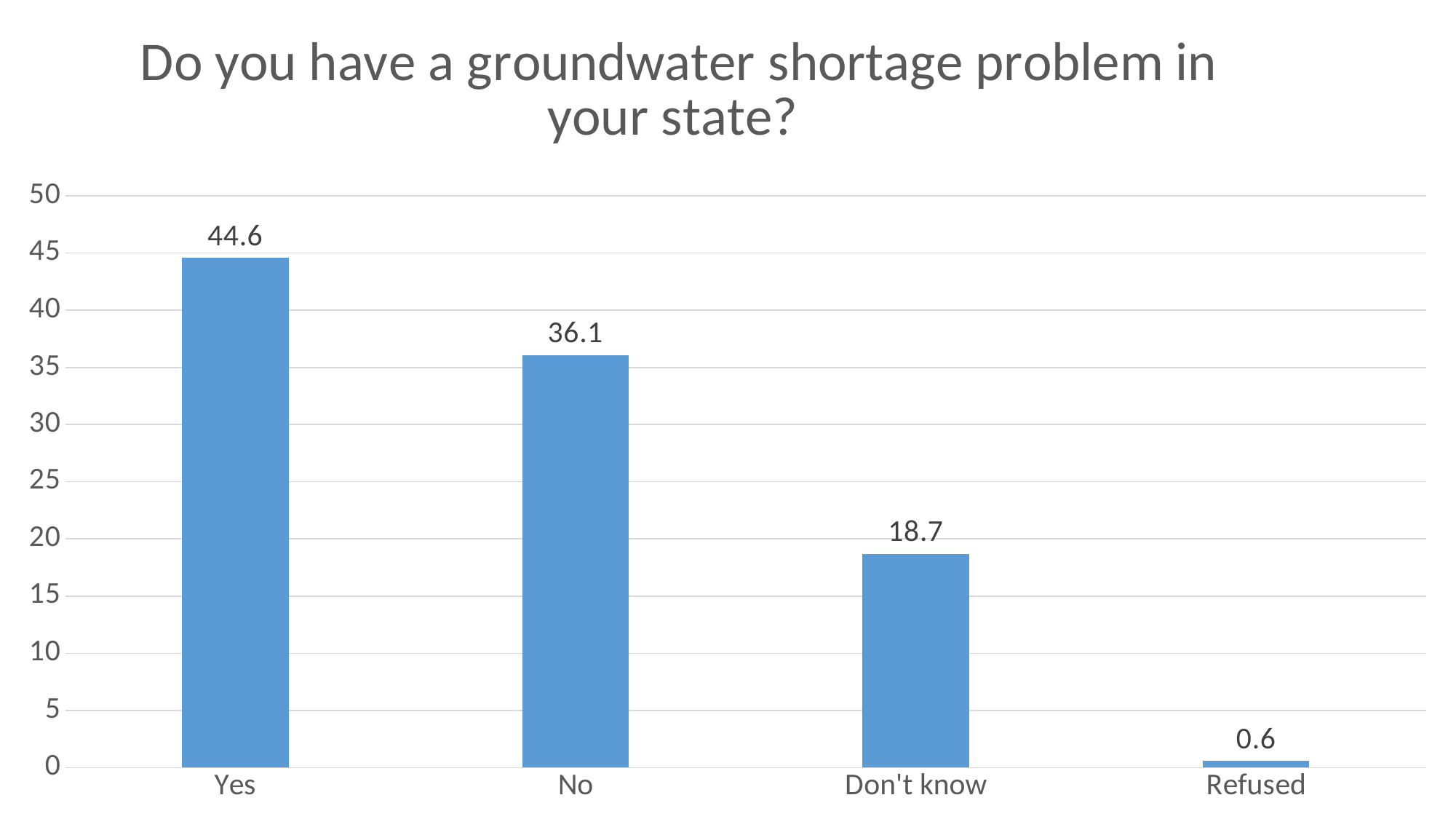
What is the value for No? 36.1 What is the value for Yes? 44.6 What is the difference between the values for Yes and No? 8.5 Which category has the lowest value? Refused What kind of chart is shown on the slide? bar chart Which is larger, the value for No or the value for Don't know? No How many categories are shown on the x axis? 4 Which category has the highest value? Yes Is the value for Don't know greater or less than 20? less What is the value for Don't know? 18.7 What is the value for Refused? 0.6 What is the title of the chart? Do you have a groundwater shortage problem in your state?